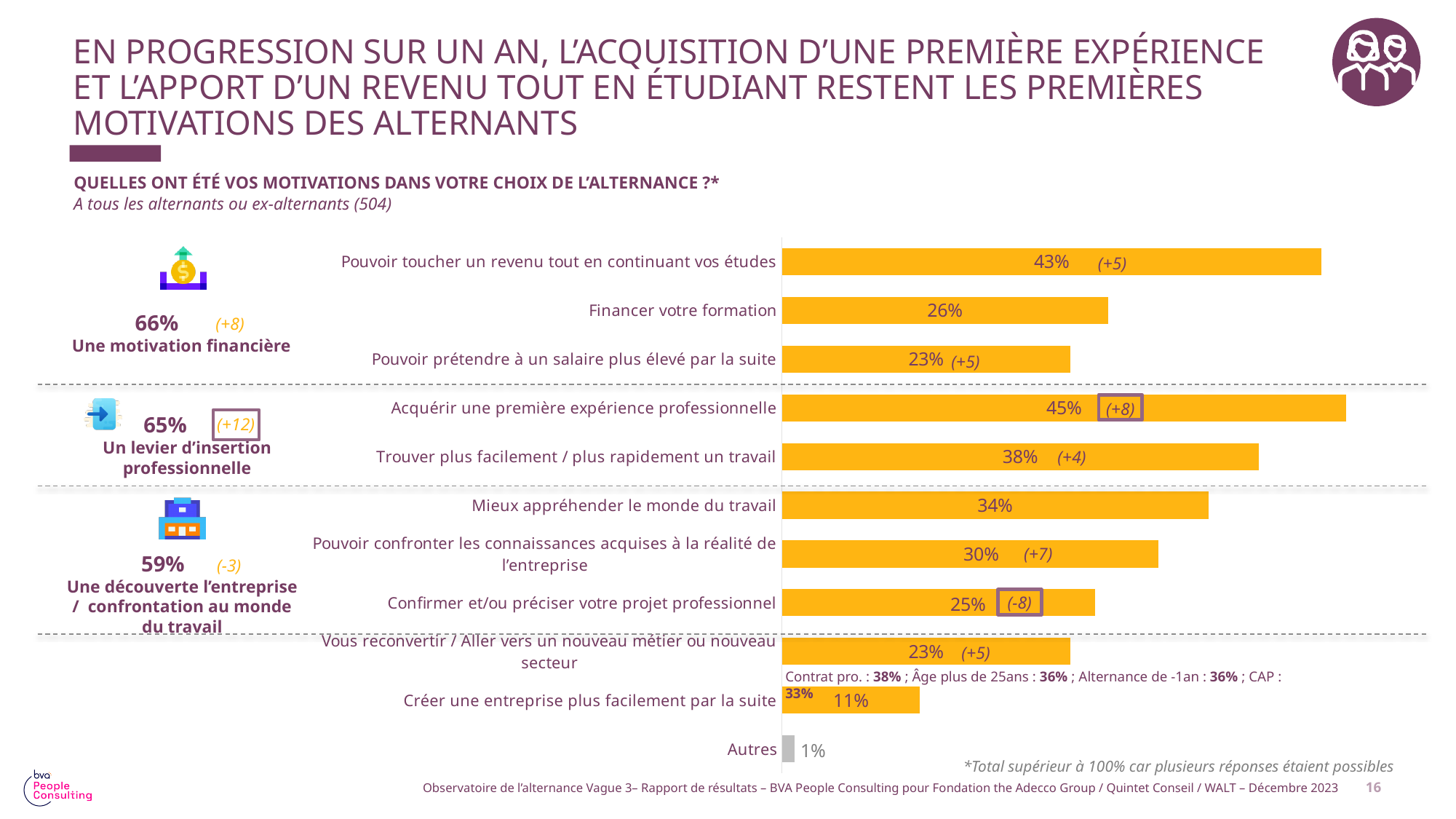
What change versus the previous year is shown next to "Acquérir une première expérience professionnelle"? (+8) What type of chart is used to display the motivations? Bar chart What percentage of respondents cited "Acquérir une première expérience professionnelle" as a motivation? 45% Which motivation has the highest percentage in the chart? Acquérir une première expérience professionnelle Which category has the lowest percentage in the chart? Autres What is the value shown for "Pouvoir toucher un revenu tout en continuant vos études"? 43% Which is larger: the value for "Mieux appréhender le monde du travail" or the value for "Pouvoir confronter les connaissances acquises à la réalité de l'entreprise"? Mieux appréhender le monde du travail How many motivation categories are plotted in the bar chart? 11 What is the value shown for "Financer votre formation"? 26% What is the difference between the values for "Pouvoir toucher un revenu tout en continuant vos études" and "Financer votre formation"? 17% What is the value shown for "Créer une entreprise plus facilement par la suite"? 11% What is the difference between the values for "Acquérir une première expérience professionnelle" and "Trouver plus facilement / plus rapidement un travail"? 7%